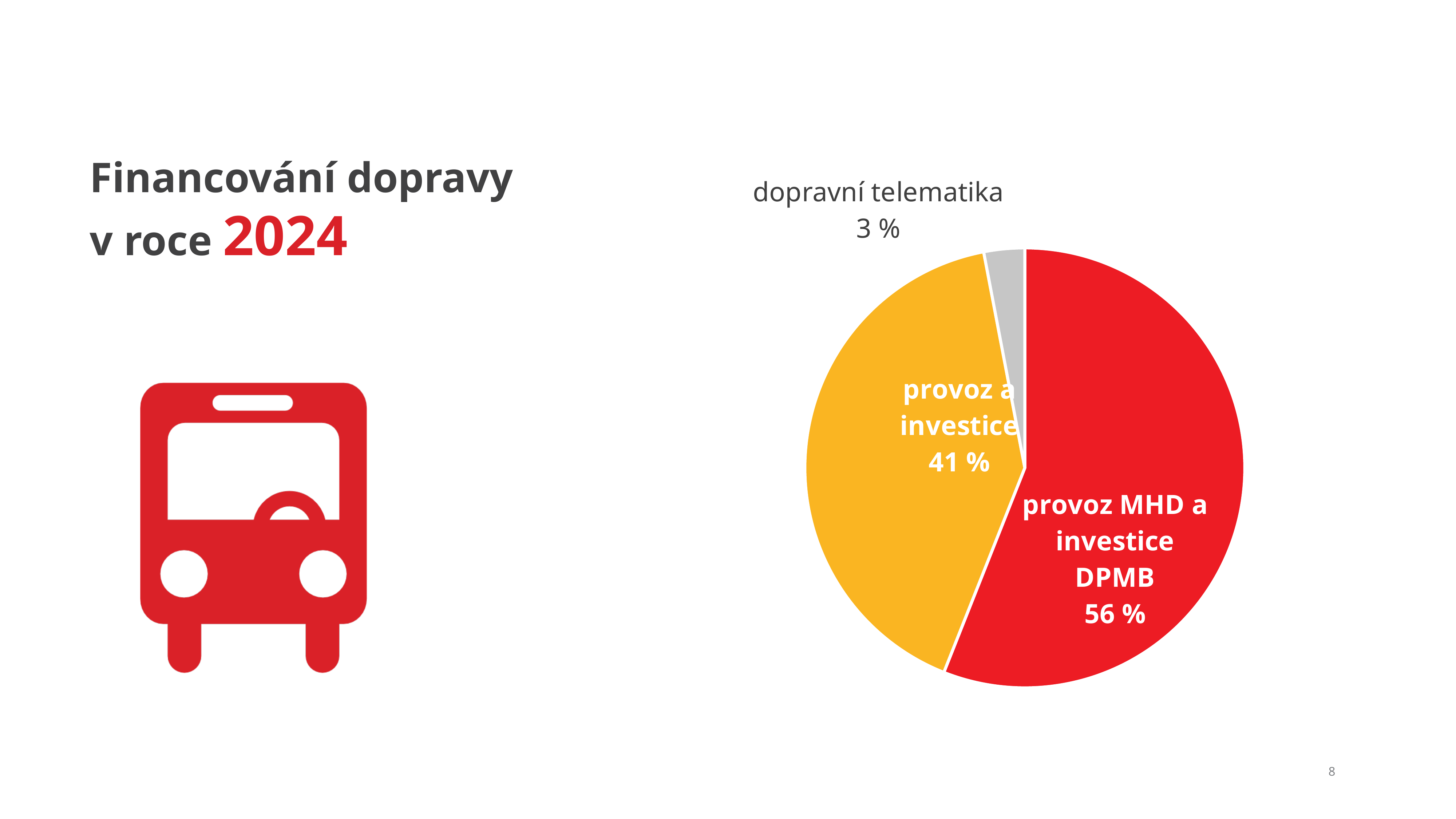
What colour is the 'provoz a investice' slice? yellow What is the difference in percentage points between 'provoz a investice' and 'dopravní telematika'? 38 % Which slice of the pie chart is the smallest? dopravní telematika What is the difference in percentage points between 'provoz MHD a investice DPMB' and 'provoz a investice'? 15 % Which is larger: the share for 'provoz a investice' or the share for 'dopravní telematika'? provoz a investice What share of the pie does 'dopravní telematika' represent? 3 % Which slice of the pie chart is the largest? provoz MHD a investice DPMB What share of the pie does 'provoz MHD a investice DPMB' represent? 56 % What type of chart is shown on the slide? pie chart What share of the pie does 'provoz a investice' represent? 41 % What colour is the 'provoz MHD a investice DPMB' slice? red How many slices does the pie chart have? 3